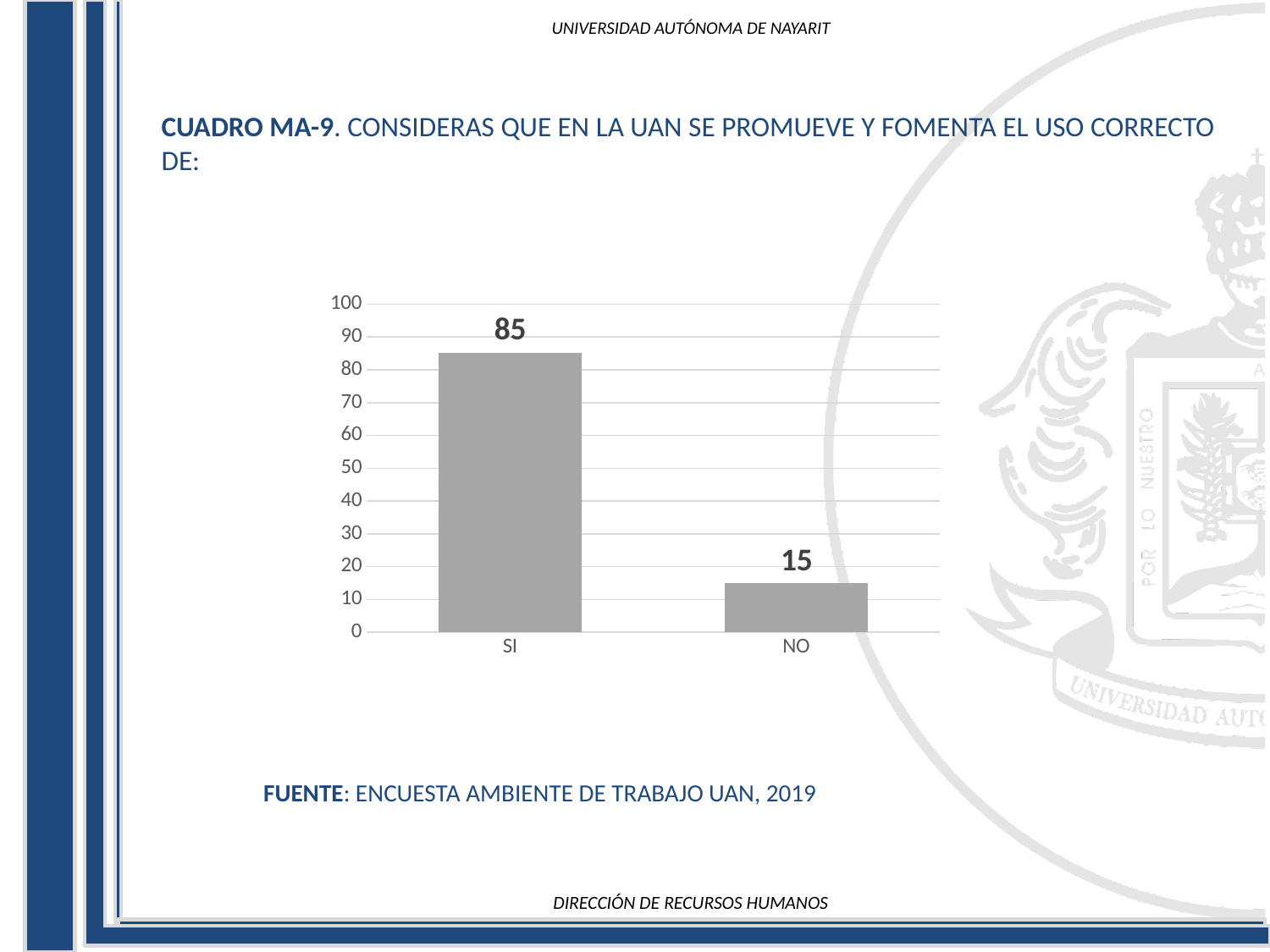
What is the value for NO? 15 How many categories are shown on the x axis? 2 Which category has the lowest value? NO Which category has the highest value? SI What is the maximum value shown on the vertical axis? 100 What source is cited below the chart? ENCUESTA AMBIENTE DE TRABAJO UAN, 2019 Is the value for NO greater or less than 20? less Which is larger, the value for SI or the value for NO? SI What is the difference between the values for SI and NO? 70 What kind of chart is shown on the slide? bar chart What is the value for SI? 85 Is the value for SI greater or less than 50? greater